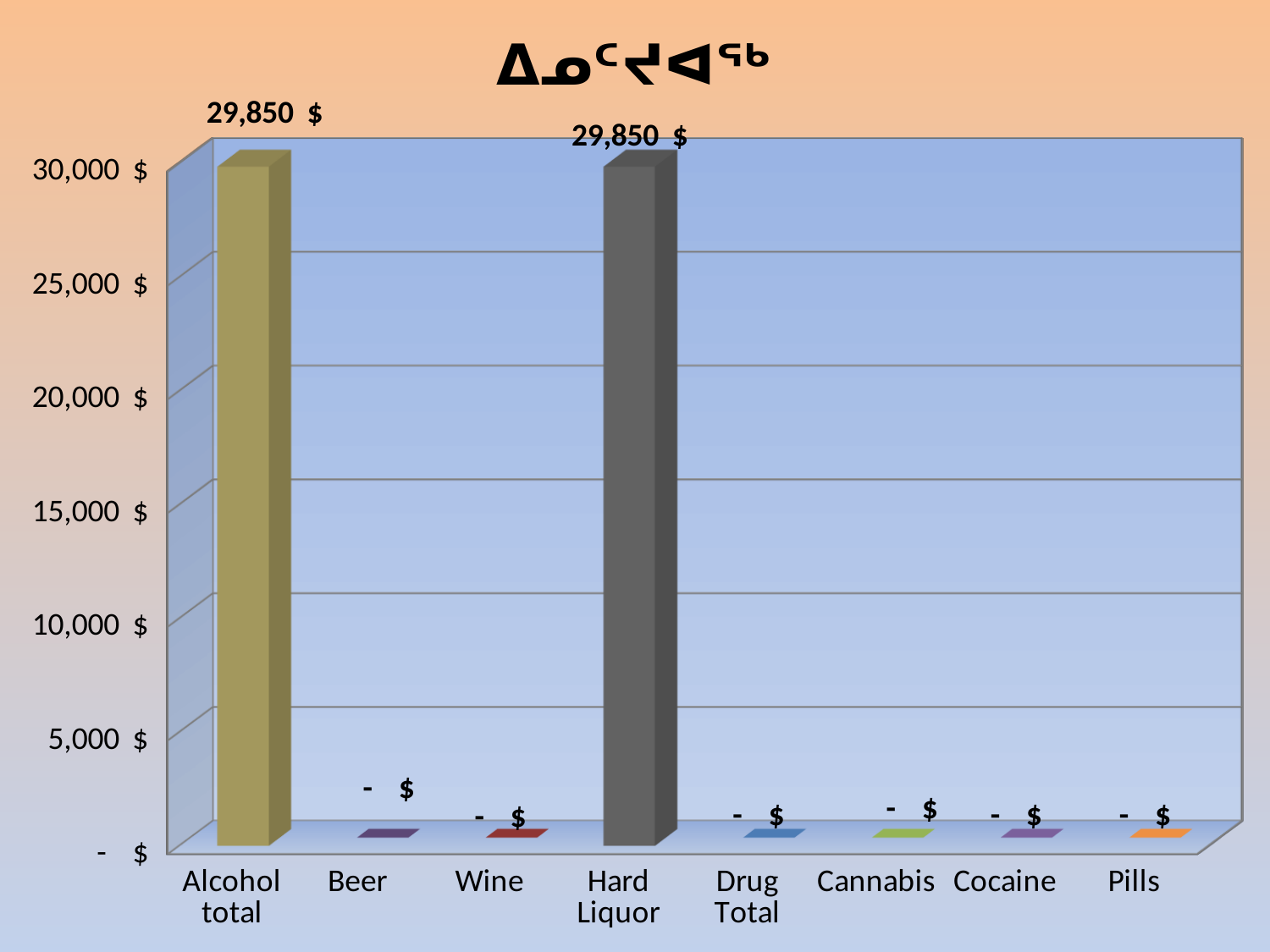
Which is larger, the value for Alcohol total or the value for Wine? Alcohol total What value is labelled for Beer? - $ What value is labelled for Cannabis? - $ Is the value for Hard Liquor greater or less than 25,000 $? greater Which is larger, the value for Hard Liquor or the value for Drug Total? Hard Liquor How many categories are shown on the x axis? 8 What is the value for Alcohol total? 29,850 $ What is the value for Hard Liquor? 29,850 $ What kind of chart is shown on the slide? bar chart How many categories are labelled with "- $"? 6 Which two categories share the highest value? Alcohol total and Hard Liquor Is the value for Cocaine greater or less than 5,000 $? less